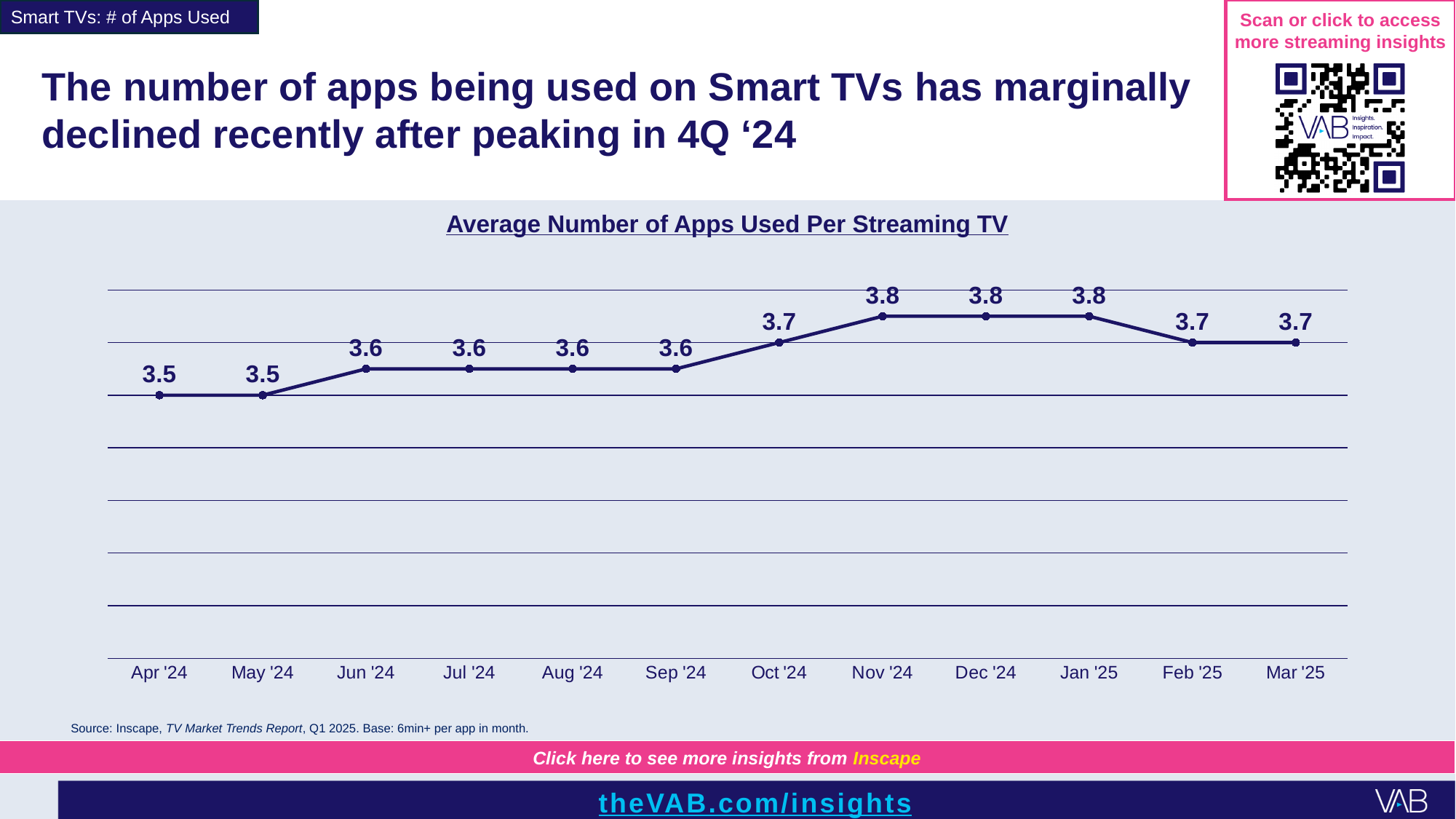
Which is larger, the value for Jan '25 or the value for Feb '25? Jan '25 What is the average number of apps used per streaming TV in Mar '25? 3.7 What is the average number of apps used per streaming TV in Oct '24? 3.7 Do the values rise or fall from Apr '24 to Nov '24? Rise What type of chart is shown on the slide? Line chart What is the difference between the value for Dec '24 and the value for Apr '24? 0.3 What is the average number of apps used per streaming TV in Nov '24? 3.8 What is the lowest value shown on the chart? 3.5 What is the title of the chart? Average Number of Apps Used Per Streaming TV What is the average number of apps used per streaming TV in Apr '24? 3.5 What is the highest value shown on the chart? 3.8 How many months are plotted on the chart? 12